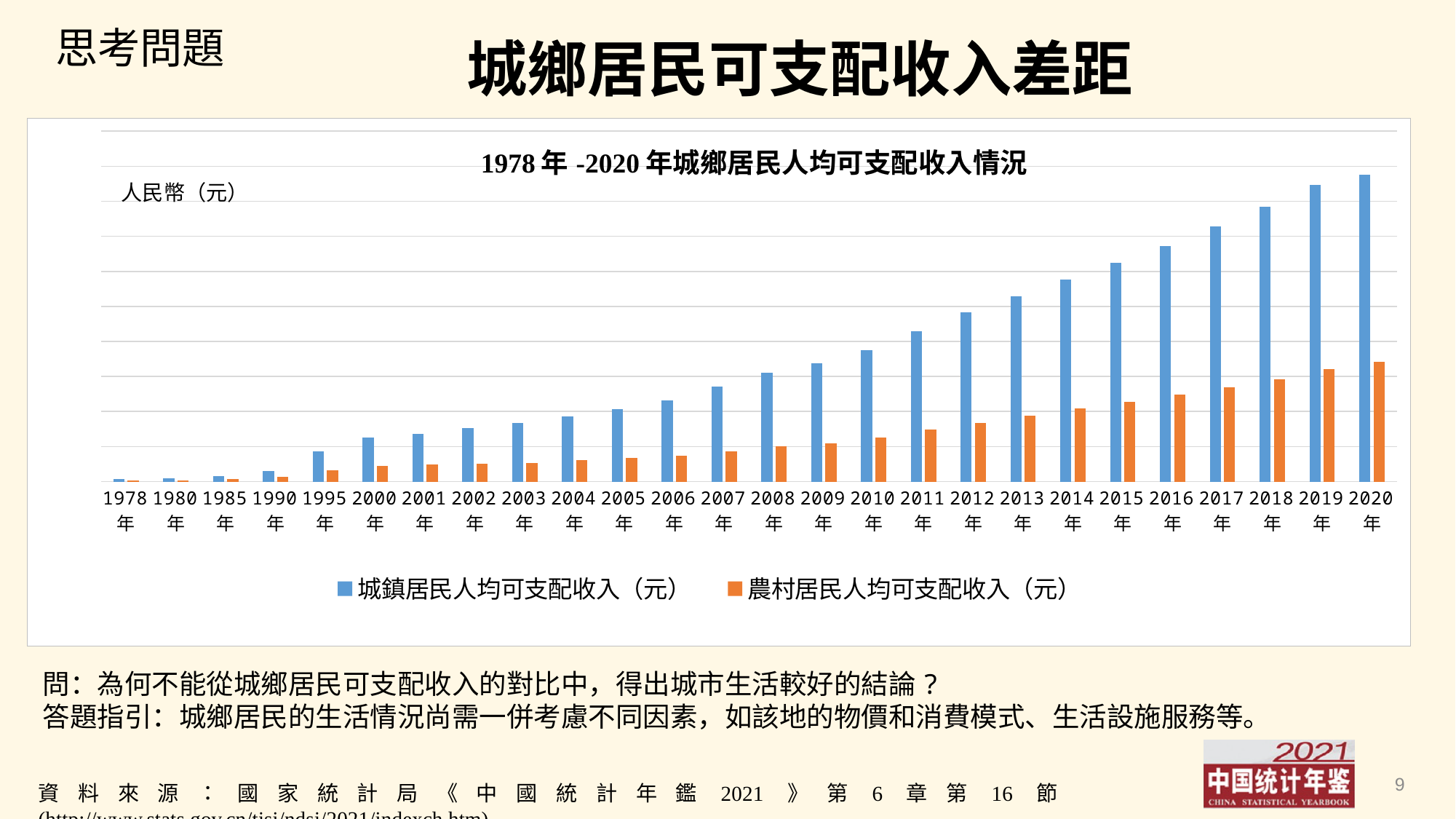
Which series is shown in orange in the chart? 農村居民人均可支配收入（元） How many series does the chart's legend list? 2 Do the values for 城鎮居民人均可支配收入（元） rise or fall from 1978年 to 2020年? rise Which year has the lowest value for 城鎮居民人均可支配收入（元）? 1978年 What kind of chart is shown on the slide? bar chart What is the title of the chart? 1978年-2020年城鄉居民人均可支配收入情況 Which year has the highest value for 城鎮居民人均可支配收入（元）? 2020年 How many years are shown along the x axis of the chart? 26 Which year has the highest value for 農村居民人均可支配收入（元）? 2020年 In 2020年, which is larger: 城鎮居民人均可支配收入（元） or 農村居民人均可支配收入（元）? 城鎮居民人均可支配收入（元） Do the values for 農村居民人均可支配收入（元） rise or fall from 1978年 to 2020年? rise Is the value for 城鎮居民人均可支配收入（元） in 2010年 larger or smaller than in 2015年? smaller